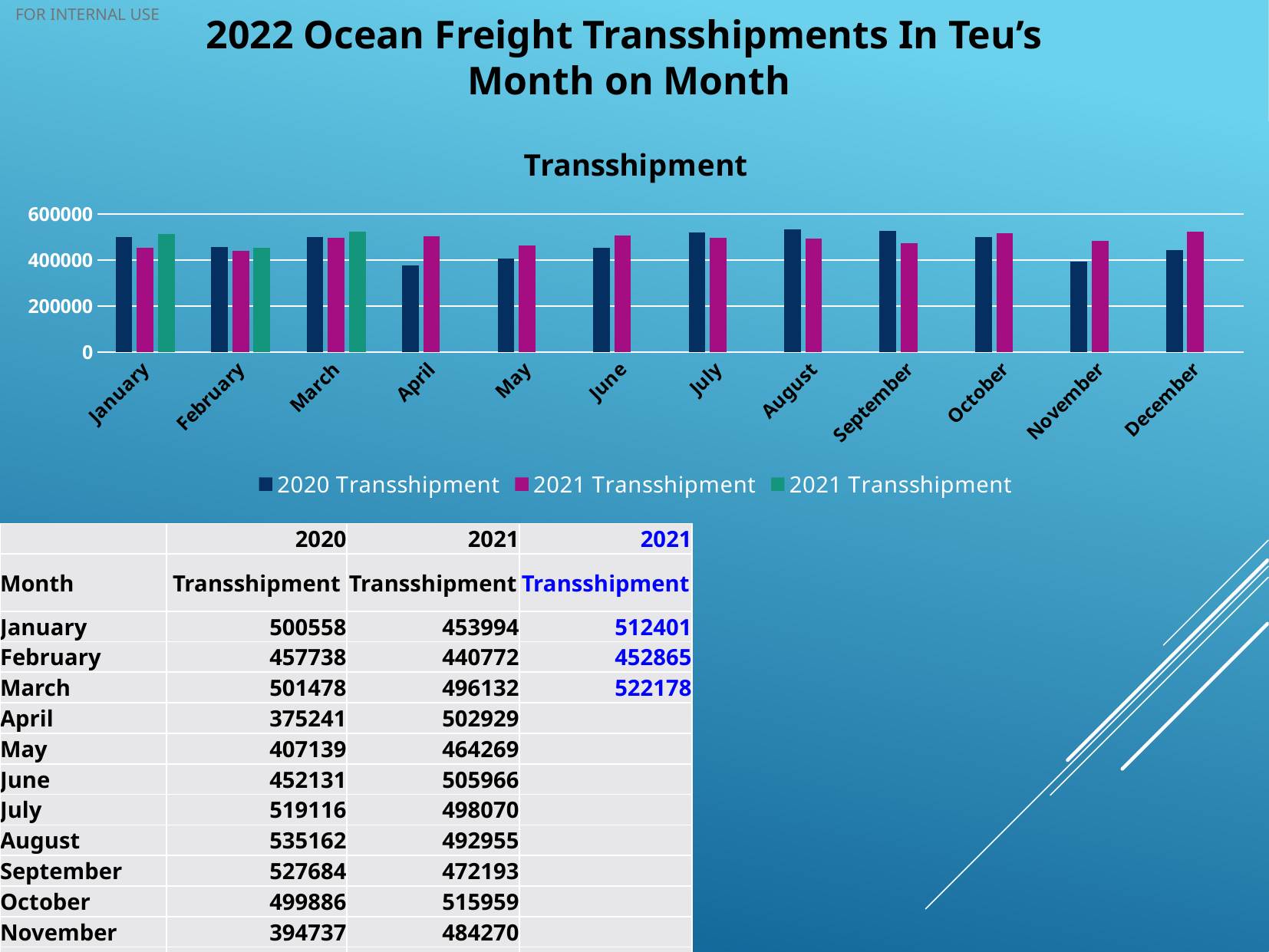
Is the green-series value for March greater or less than 400000? greater What kind of chart is shown on the slide? bar chart For how many months does the chart show a green (third series) bar? 3 What is the difference between the 2020 Transshipment and the magenta 2021 Transshipment for January? 46564 Which month has the highest 2020 Transshipment value? August Which month has the lowest 2020 Transshipment value? April What is the 2020 Transshipment value for August? 535162 How many series does the chart legend list? 3 What is the 2021 Transshipment value (magenta series) for April? 502929 Is the 2020 Transshipment value for April greater or less than 400000? less How many months are shown along the x axis of the chart? 12 For April, which is larger: the 2020 Transshipment or the magenta 2021 Transshipment? 2021 Transshipment